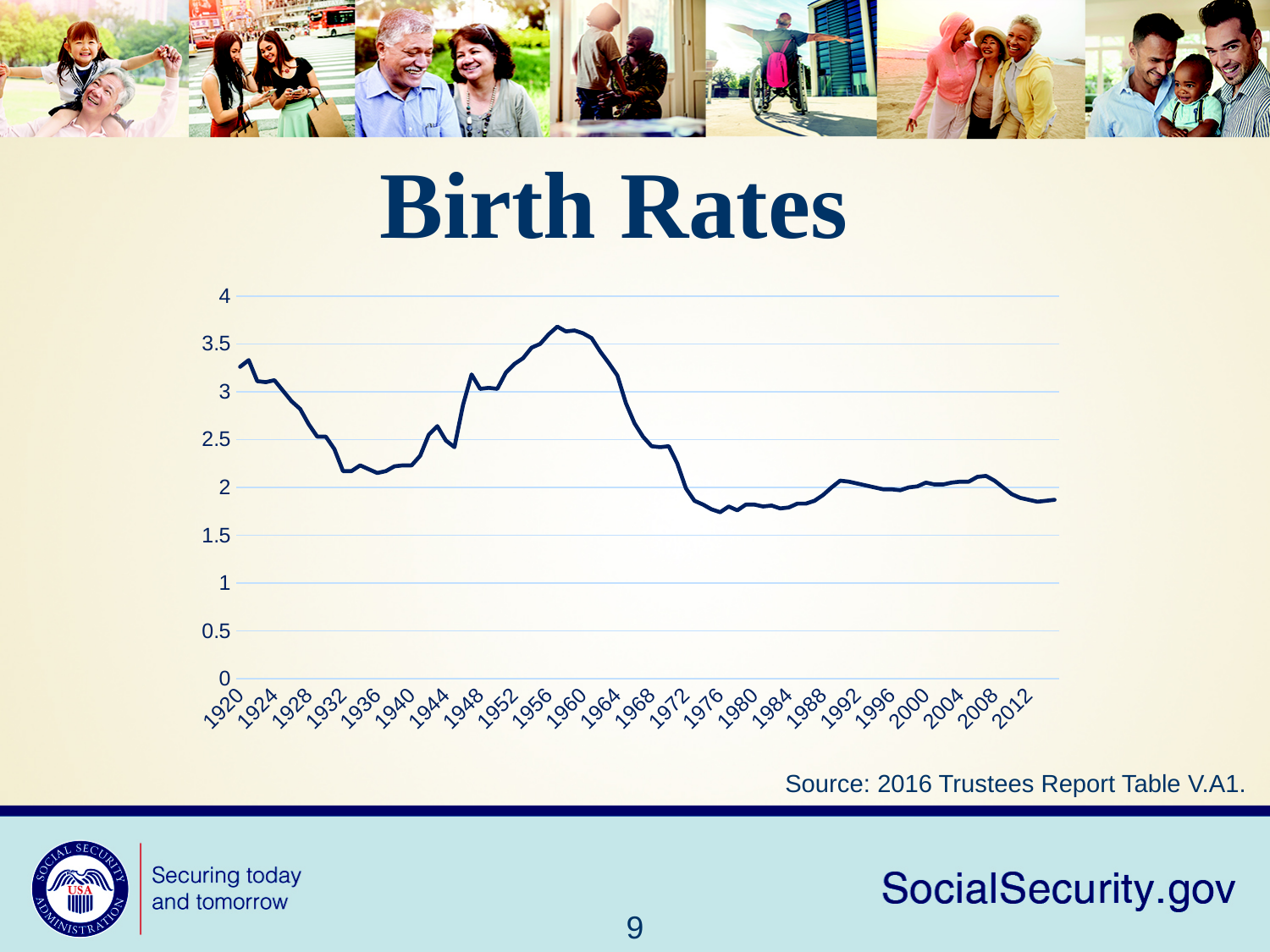
Is the birth rate value for 1976 greater or less than 2? less Is the birth rate value for 1920 greater or less than 3? greater Is the birth rate value for 2012 greater or less than 2? less Which year has the highest birth rate on the chart, 1960 or 1980? 1960 Does the birth rate rise or fall between 1960 and 1976? fall What is the title of the chart? Birth Rates What is the source cited for the chart? 2016 Trustees Report Table V.A1. Does the birth rate rise or fall between 1920 and 1936? fall What kind of chart is shown on the slide? line chart